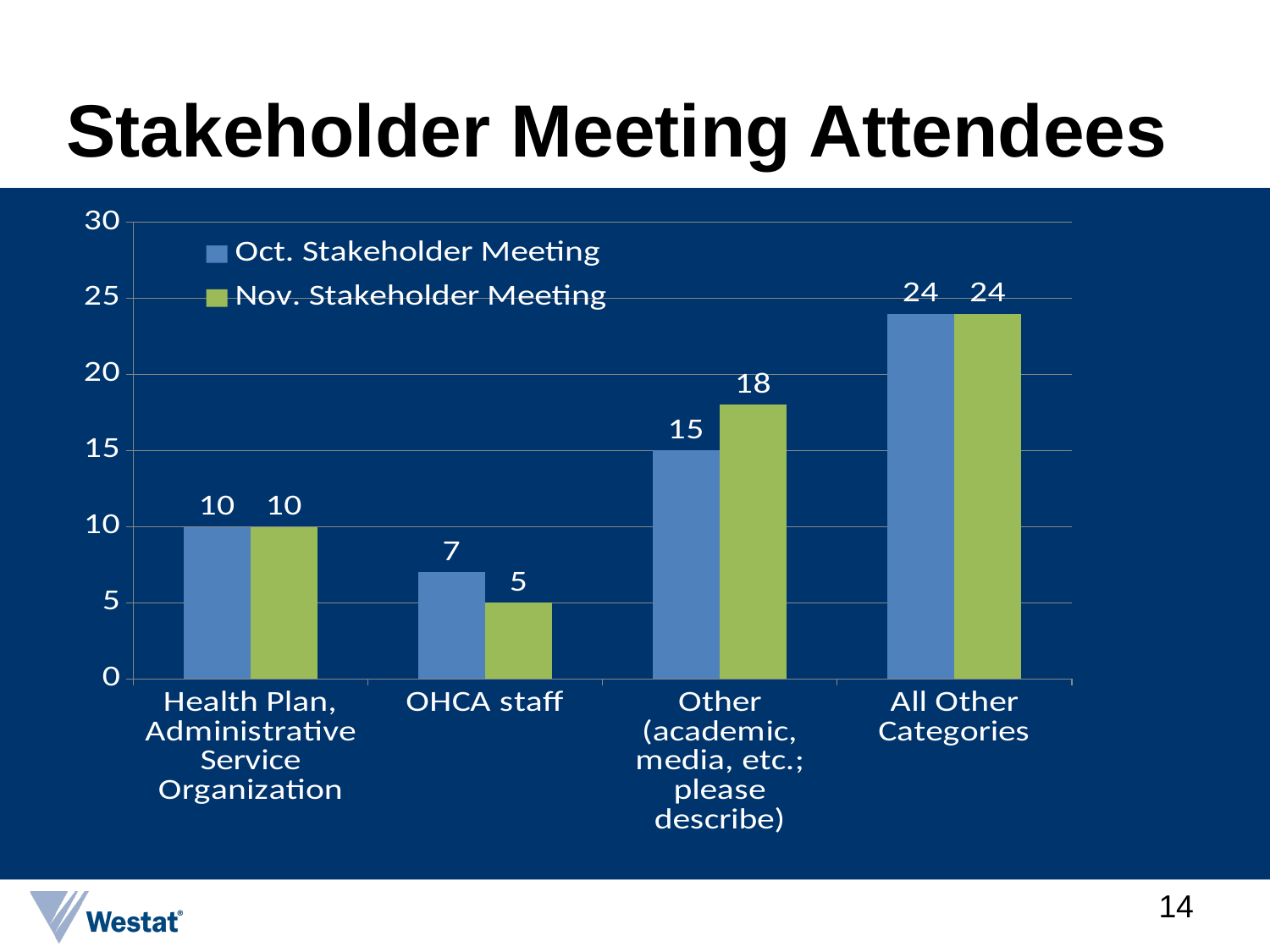
Which category has the lowest value in the Oct. Stakeholder Meeting series? OHCA staff How many categories are shown on the x axis? 4 What is the value for OHCA staff in the Oct. Stakeholder Meeting series? 7 How many series does the legend list? 2 What is the difference between the Nov. and Oct. Stakeholder Meeting values for Other (academic, media, etc.; please describe)? 3 Which category has the highest value in the Nov. Stakeholder Meeting series? All Other Categories What is the title of the slide? Stakeholder Meeting Attendees What is the difference between the Oct. and Nov. Stakeholder Meeting values for OHCA staff? 2 What is the value for All Other Categories in the Oct. Stakeholder Meeting series? 24 Which is larger for OHCA staff: the Oct. Stakeholder Meeting value or the Nov. Stakeholder Meeting value? Oct. Stakeholder Meeting What is the value for Other (academic, media, etc.; please describe) in the Nov. Stakeholder Meeting series? 18 What kind of chart is shown on the slide? Bar chart